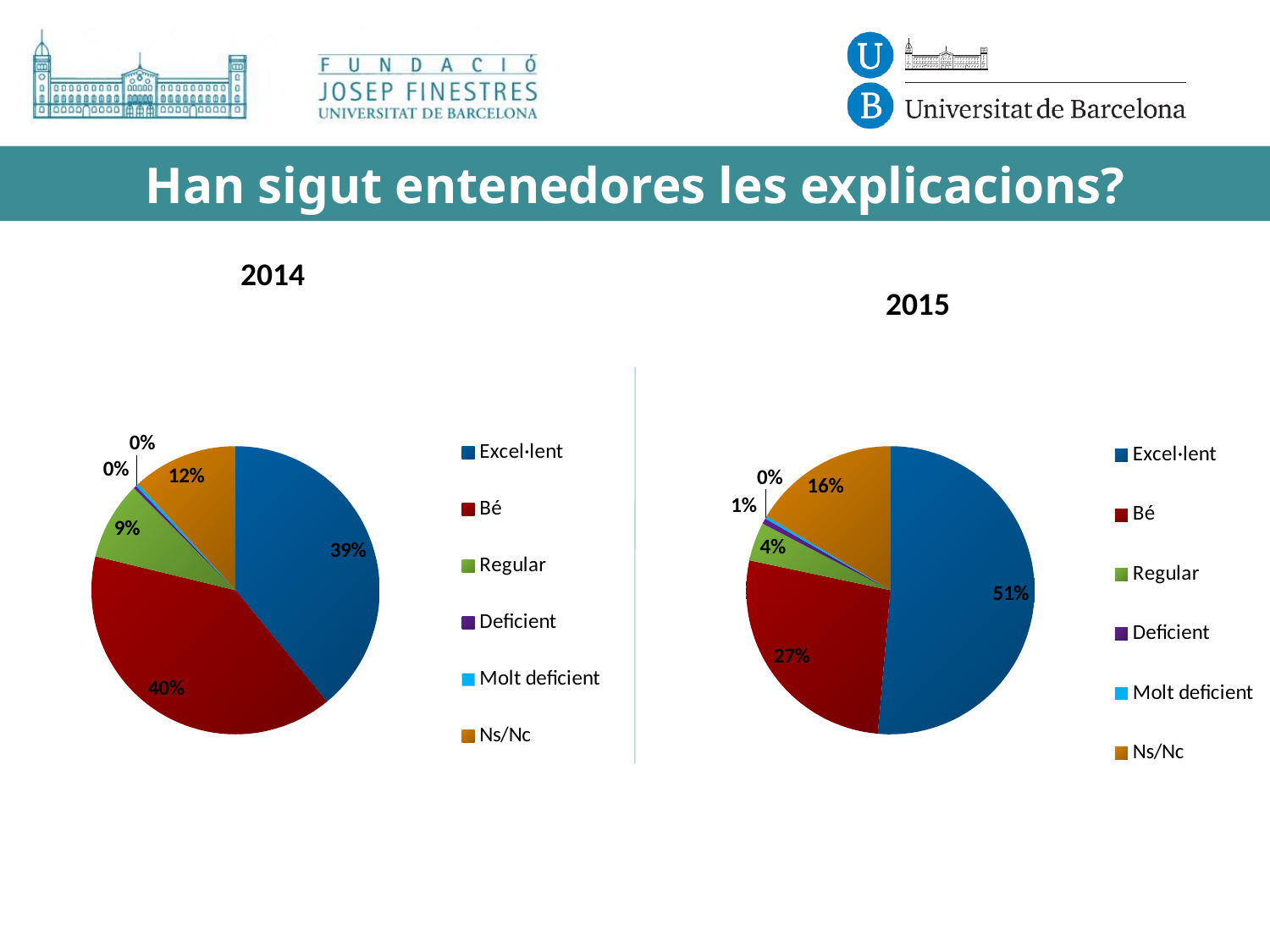
In the 2015 pie chart, which is larger, Bé or Ns/Nc? Bé What is the difference between the Excel·lent share in 2015 and in 2014? 12% In the 2014 pie chart, what share is labelled for Excel·lent? 39% In the 2015 pie chart, which category has the largest slice? Excel·lent In the 2015 pie chart, what share is labelled for Ns/Nc? 16% In the 2014 pie chart, what share is labelled for Bé? 40% In the 2015 pie chart, what share is labelled for Excel·lent? 51% What type of chart is used for the 2014 data? Pie chart In the 2014 pie chart, which category has the largest slice? Bé How many categories does the legend of the 2015 pie chart list? 6 In the 2015 pie chart, what share is labelled for Regular? 4% In the 2014 pie chart, what is the difference between the Ns/Nc share and the Regular share? 3%